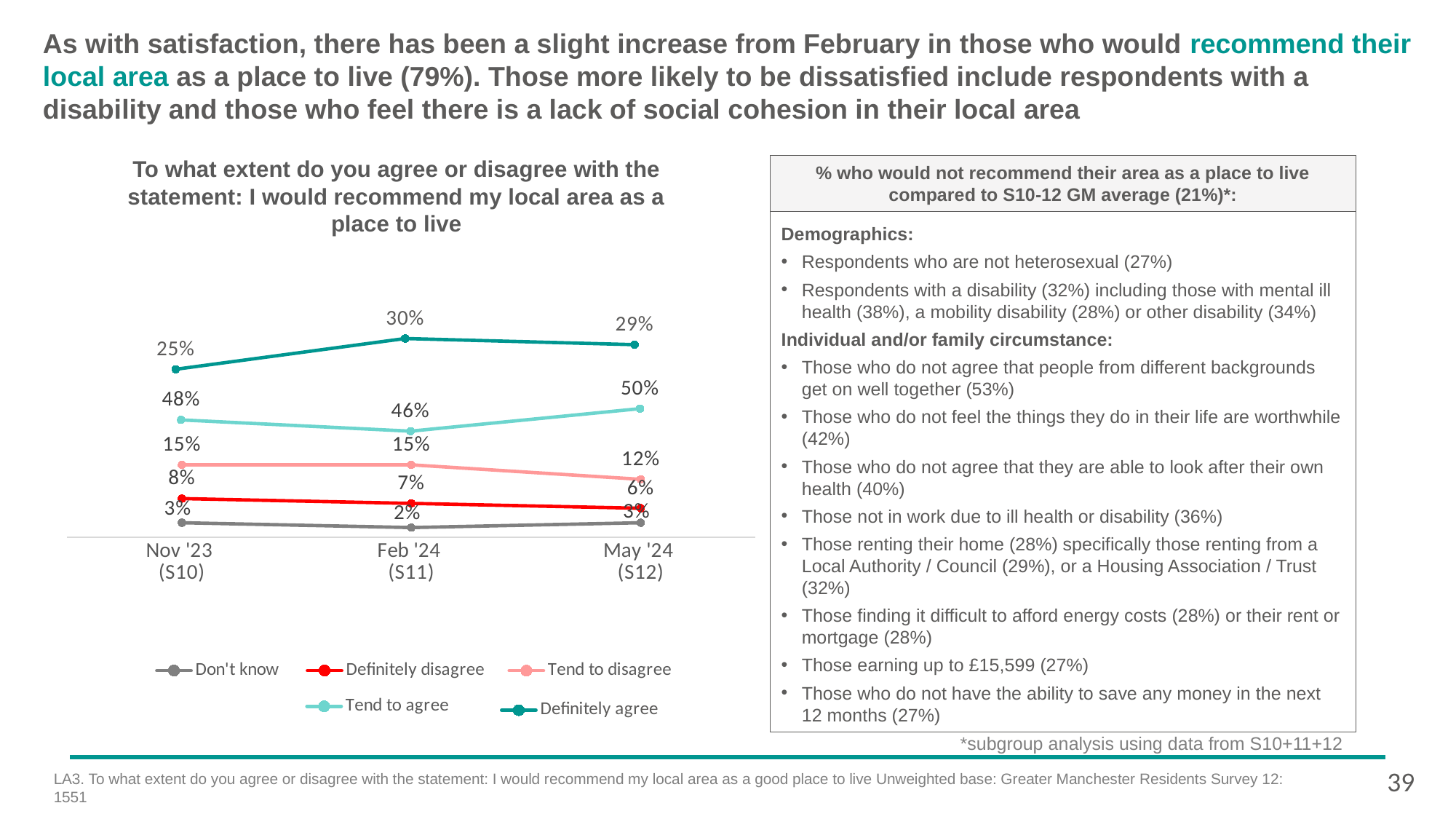
In which time point is 'Don't know' lowest? Feb '24 (S11) What type of chart is shown on the slide? Line chart What is the value for 'Definitely disagree' in Feb '24 (S11)? 7% What is the value for 'Tend to agree' in May '24 (S12)? 50% What is the value for 'Tend to disagree' in Nov '23 (S10)? 15% How many series does the chart legend list? 5 What is the value for 'Definitely agree' in Feb '24 (S11)? 30% What is the difference between 'Tend to agree' and 'Definitely agree' in May '24 (S12)? 21% Does the value for 'Tend to disagree' rise or fall from Feb '24 (S11) to May '24 (S12)? Fall In which time point is 'Tend to agree' highest? May '24 (S12) Which is larger in Nov '23 (S10): 'Definitely disagree' or 'Tend to disagree'? Tend to disagree How many time points are plotted along the x axis? 3